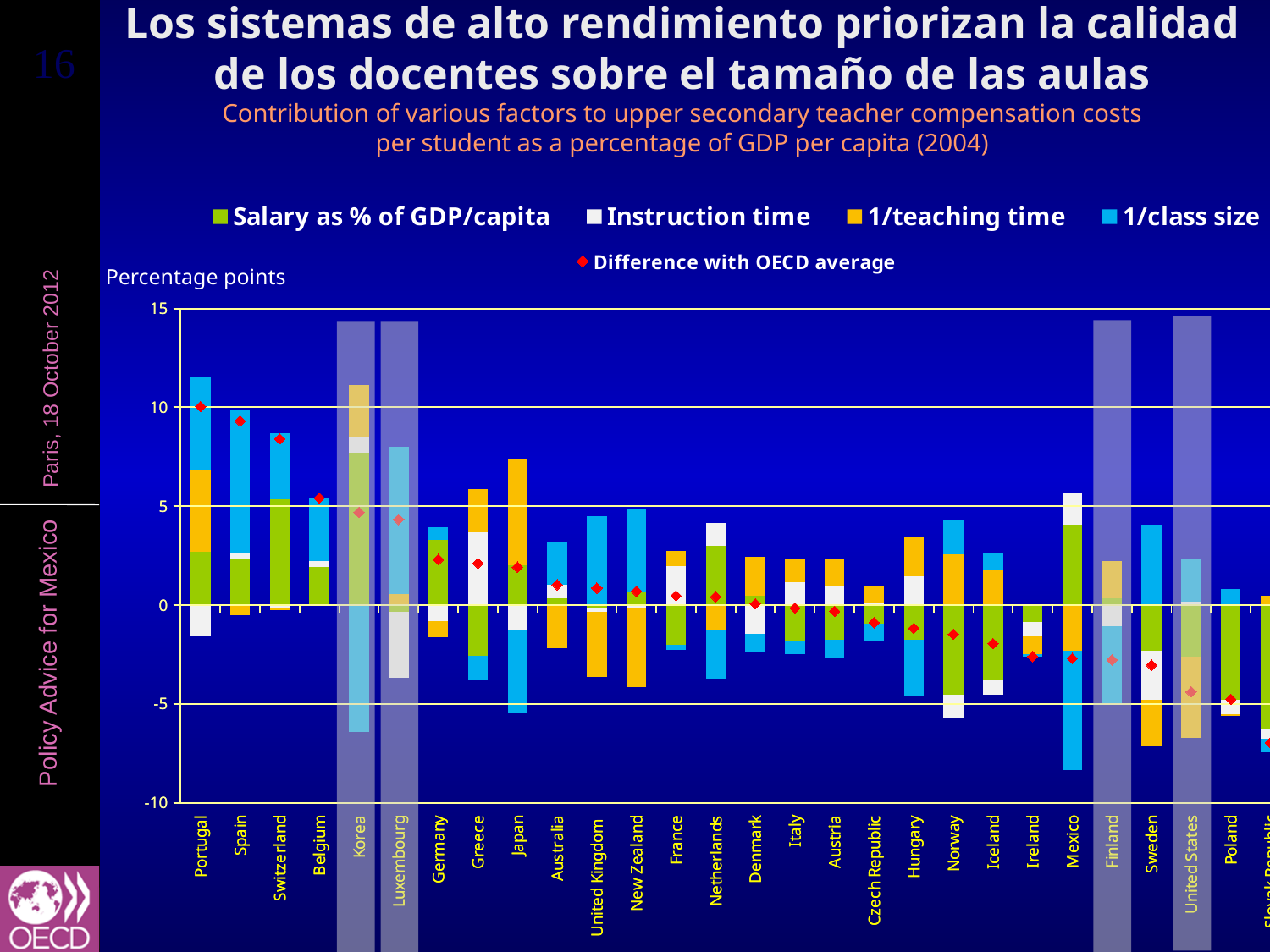
Is the 'Difference with OECD average' value for Germany greater or less than 0? greater What kind of chart is shown on the slide? bar chart How many series does the legend list? 5 Is the 'Difference with OECD average' value for United States greater or less than 0? less Is the 'Difference with OECD average' value for Spain greater or less than 5? greater Which country has the larger 'Difference with OECD average' value, Switzerland or Mexico? Switzerland What is the label on the vertical axis of the chart? Percentage points Which series is shown in green in the legend? Salary as % of GDP/capita Do the 'Difference with OECD average' markers generally rise or fall from left to right across the countries? fall Which country has the highest 'Difference with OECD average' marker? Portugal